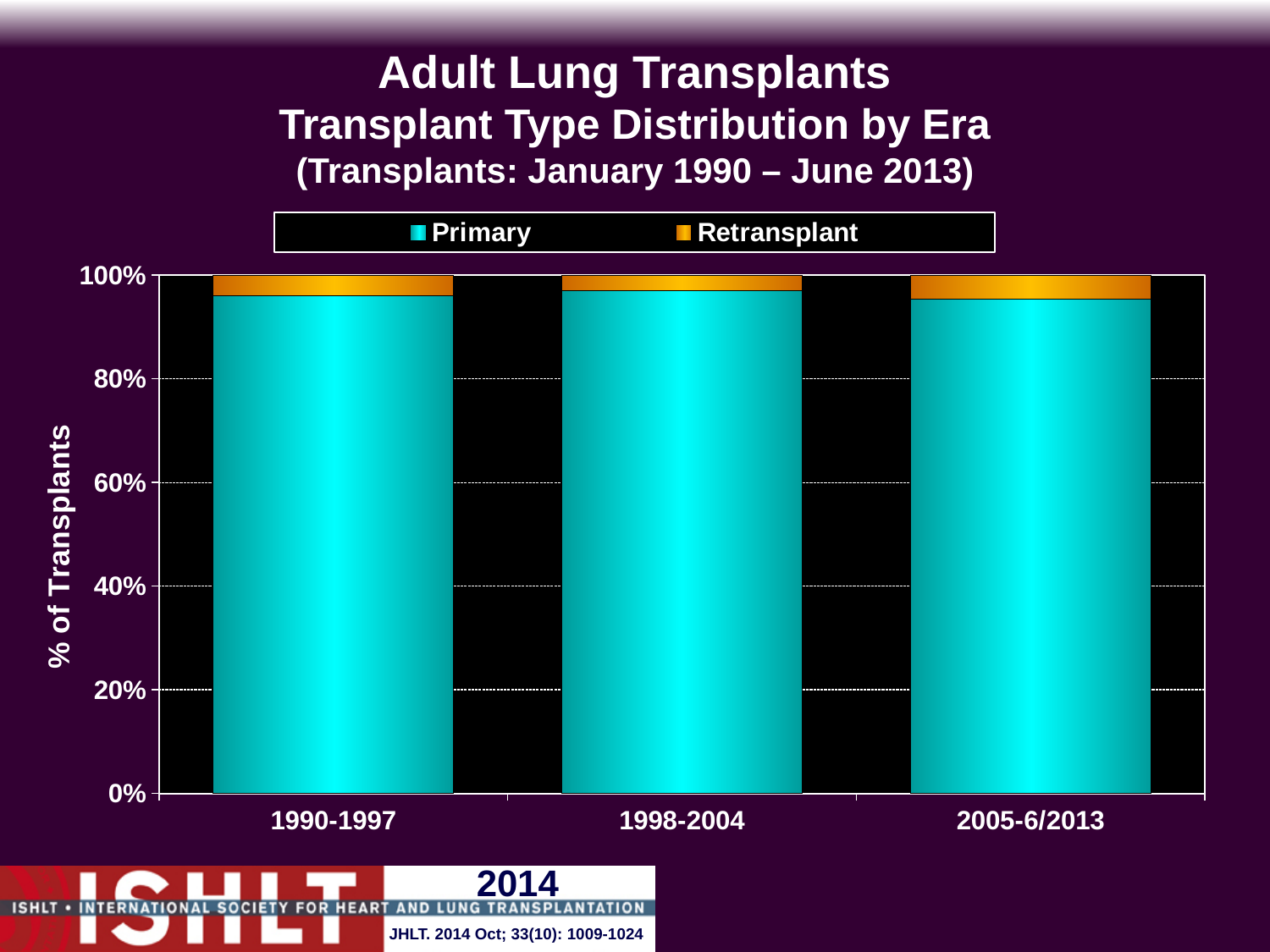
In the 1998-2004 era, which is larger, the Primary share or the Retransplant share? Primary What is the total height of the stacked bar for 1990-1997? 100% Which series is shown in orange? Retransplant Is the Primary share for 1998-2004 greater or less than 60%? greater What is the label of the y axis? % of Transplants Is the Primary share for 1990-1997 greater or less than 80%? greater Which era has the larger Retransplant share, 1998-2004 or 2005-6/2013? 2005-6/2013 How many series does the legend list? 2 Is the Retransplant share for 2005-6/2013 greater or less than 20%? less Which two series are listed in the legend? Primary and Retransplant How many era categories are shown on the x axis? 3 What kind of chart is shown on the slide? stacked bar chart